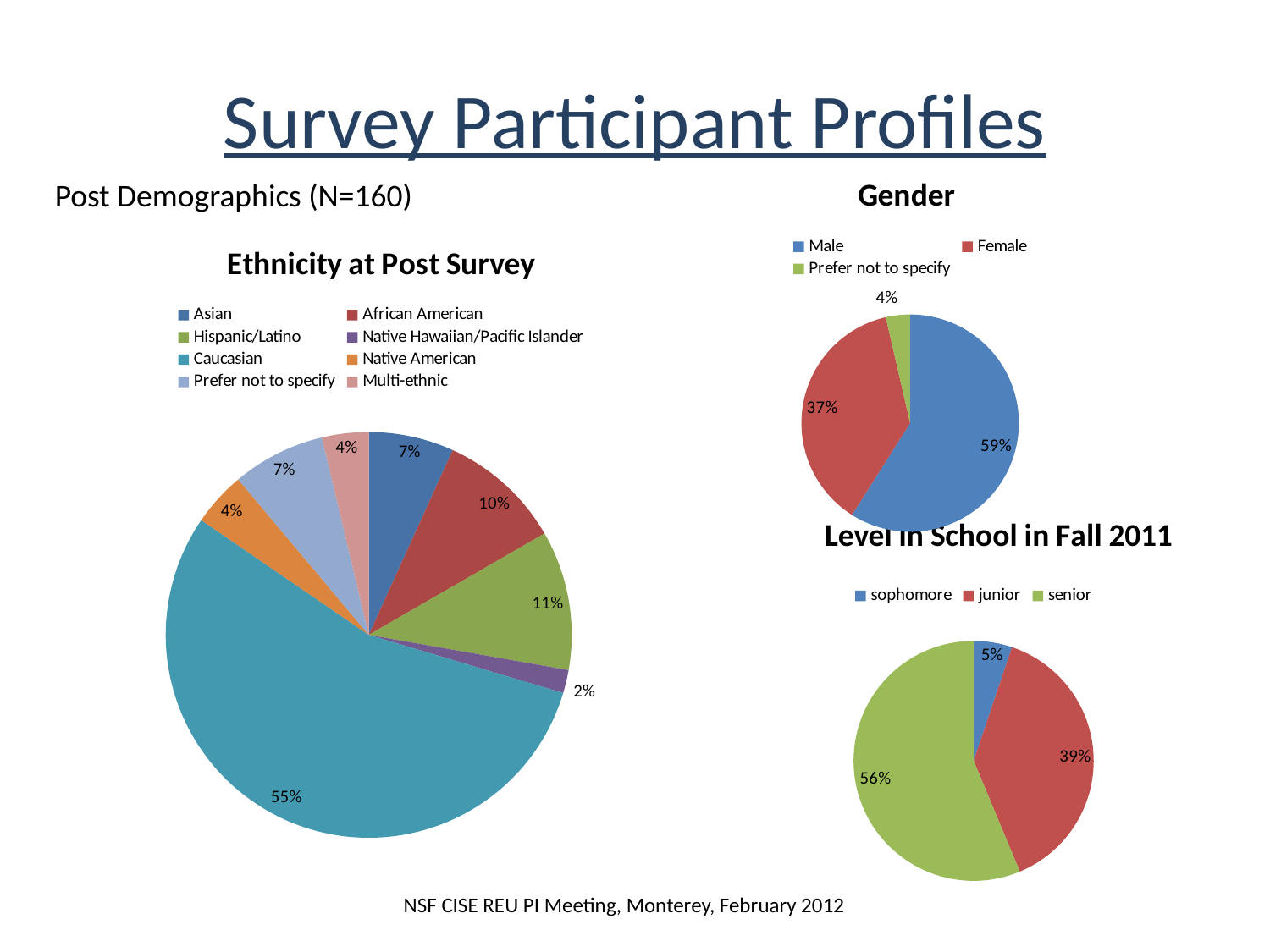
In the 'Gender' chart, what share of the pie is Female? 37% What kind of chart is the 'Level in School in Fall 2011' chart? Pie chart In the 'Ethnicity at Post Survey' chart, which category has the smallest slice? Native Hawaiian/Pacific Islander In the 'Level in School in Fall 2011' chart, what is the value for junior? 39% In the 'Ethnicity at Post Survey' chart, what share of the pie is Caucasian? 55% In the 'Level in School in Fall 2011' chart, how many categories does the legend list? 3 In the 'Level in School in Fall 2011' chart, which is larger, senior or junior? senior In the 'Gender' chart, which category is the largest? Male In the 'Ethnicity at Post Survey' chart, what is the difference between the African American and Asian shares? 3% In the 'Ethnicity at Post Survey' chart, what is the value for Hispanic/Latino? 11% In the 'Ethnicity at Post Survey' chart, how many categories does the legend list? 8 In the 'Gender' chart, what is the difference between the Male and Female shares? 22%